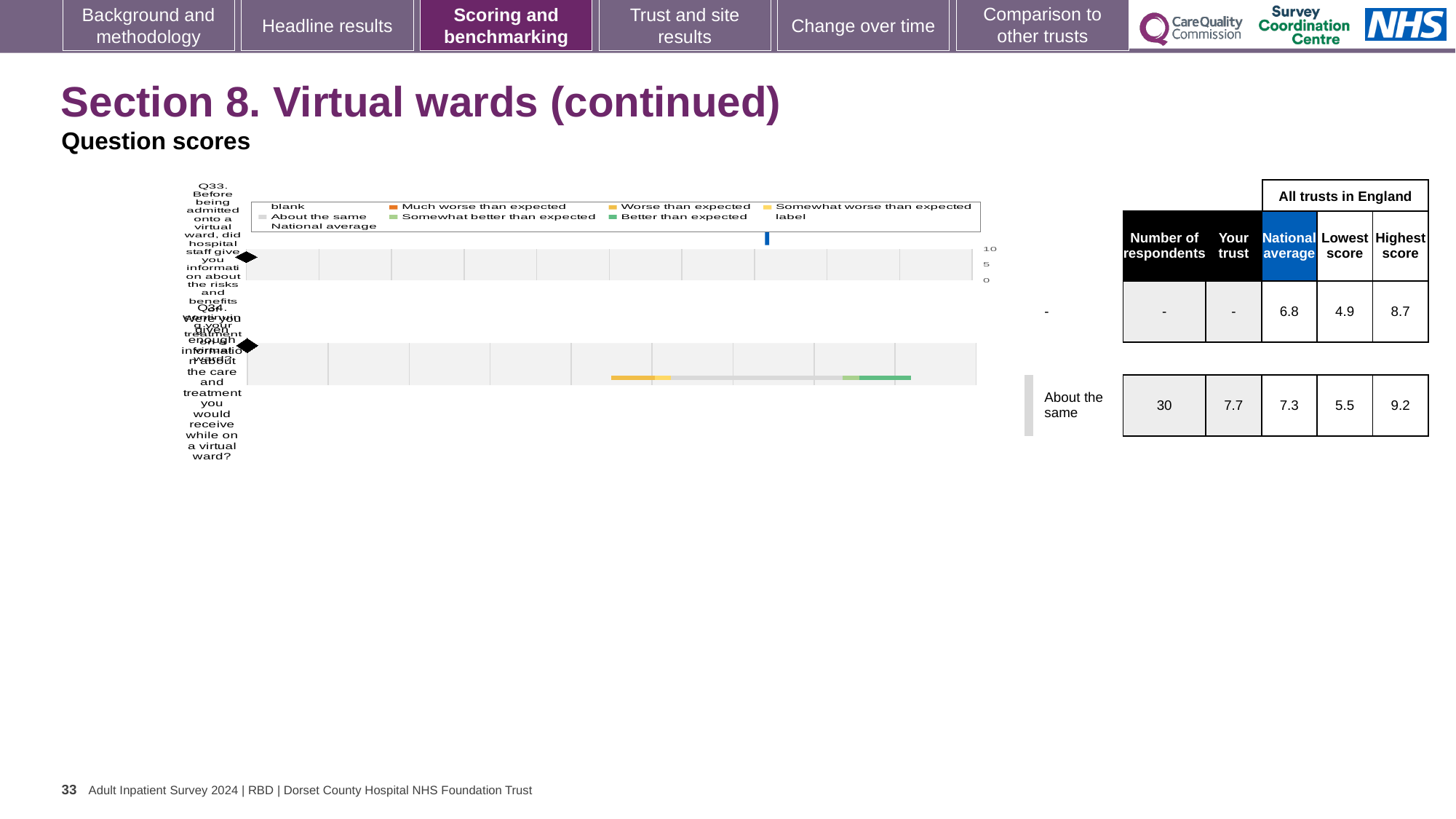
How many respondents are listed for Q34? 30 What is the lowest score among all trusts in England for Q33? 4.9 What is the highest score among all trusts in England for Q34? 9.2 For Q34, which is larger: the 'Your trust' score or the national average? Your trust What is the difference between the highest and lowest scores for Q34? 3.7 What is the 'Your trust' score for Q34? 7.7 How many questions (categories) are plotted on the chart? 2 What kind of chart is shown on the slide? bar chart Which question has the higher national average, Q33 or Q34? Q34 What is the national average score for Q34? 7.3 What is the national average score for Q33? 6.8 Which benchmark category is the trust's Q34 result placed in? About the same